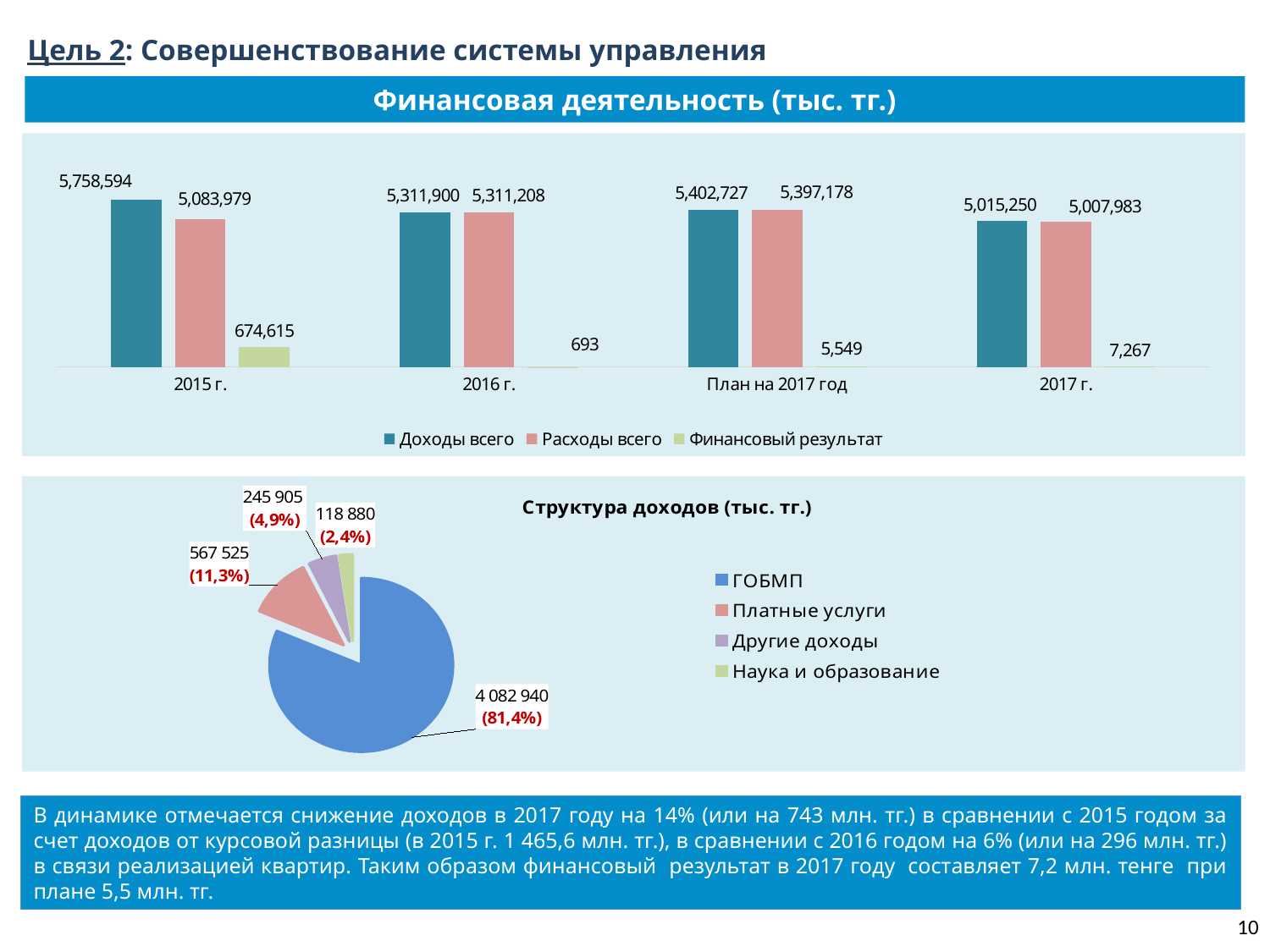
In the chart 'Финансовая деятельность (тыс. тг.)', which period has the highest 'Доходы всего'? 2015 г. In the pie chart 'Структура доходов (тыс. тг.)', which category is the smallest? Наука и образование In the pie chart 'Структура доходов (тыс. тг.)', what is the value for 'Платные услуги'? 567 525 In the pie chart 'Структура доходов (тыс. тг.)', what share does 'ГОБМП' have? 81,4% What kind of chart is 'Финансовая деятельность (тыс. тг.)'? Bar chart In the chart 'Финансовая деятельность (тыс. тг.)', what is the value of 'Расходы всего' for 'План на 2017 год'? 5,397,178 In the chart 'Финансовая деятельность (тыс. тг.)', how many series does the legend list? 3 In the chart 'Финансовая деятельность (тыс. тг.)', what is the value of 'Финансовый результат' for 2017 г.? 7,267 In the chart 'Финансовая деятельность (тыс. тг.)', what is the value of 'Доходы всего' for 2015 г.? 5,758,594 In the pie chart 'Структура доходов (тыс. тг.)', how many categories are shown? 4 In the chart 'Финансовая деятельность (тыс. тг.)', which period has the lowest 'Финансовый результат'? 2016 г. In the chart 'Финансовая деятельность (тыс. тг.)', what is the difference between 'Доходы всего' and 'Расходы всего' for 2015 г.? 674,615